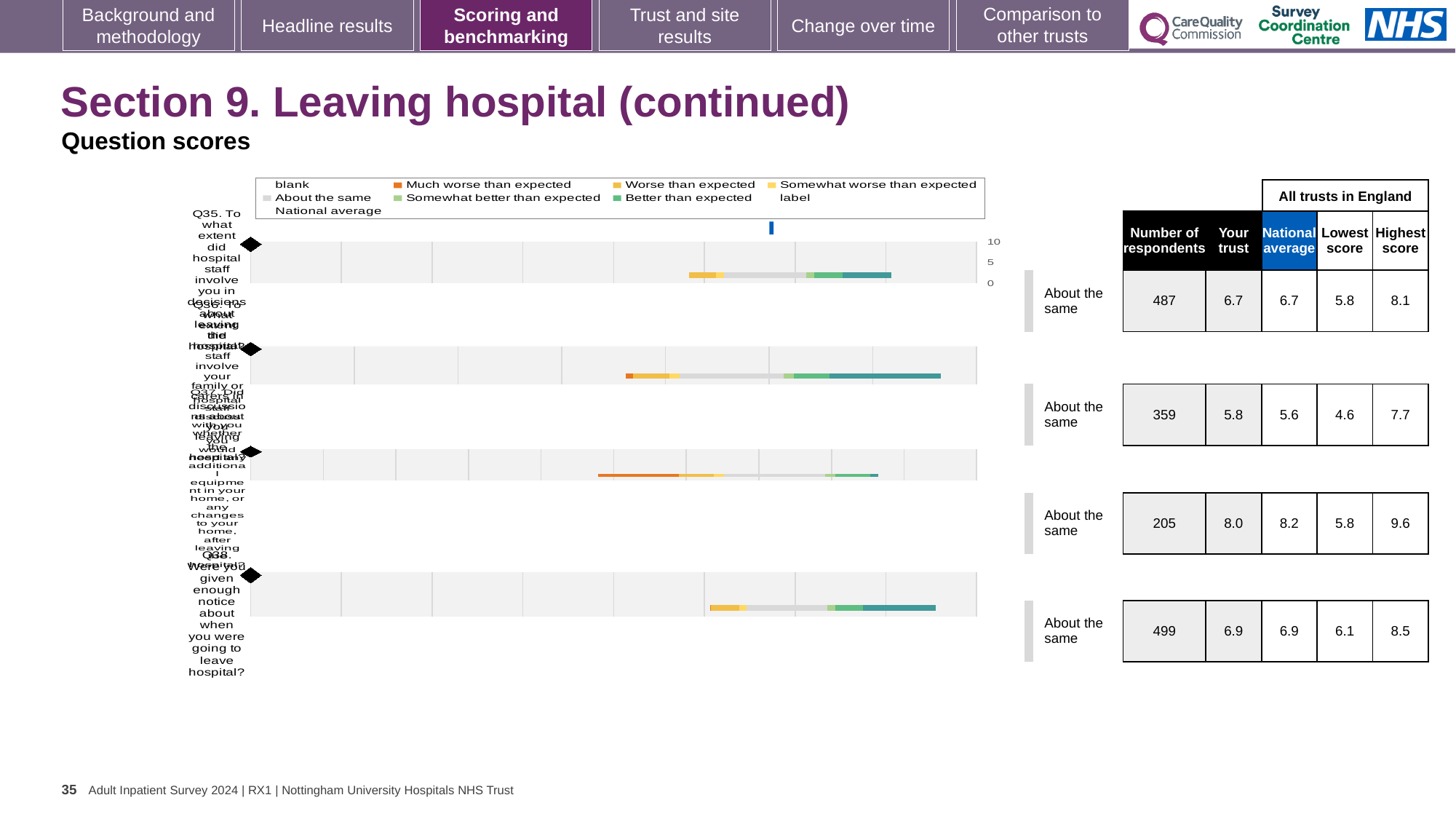
For the third chart from the top, what is the difference between the highest score (9.6) and the lowest score (5.8)? 3.8 For the top chart (Q35, involving you in decisions about leaving hospital), what is the 'Your trust' score shown in the table? 6.7 For the bottom chart (Q38), what is the highest score among all trusts in England? 8.5 How many question-score bar charts are shown on the slide? 4 For the top chart (Q35), how many respondents are listed? 487 Which of the four charts has the highest 'Your trust' score? the third chart from the top (8.0) Which of the four charts has the fewest respondents? the third chart from the top (205) For the bottom chart (Q38, given enough notice about leaving hospital), what is the 'Your trust' score? 6.9 What benchmark category label is shown next to each of the four charts? About the same For the third chart from the top, what is the lowest score among all trusts in England? 5.8 What kind of chart is used for the question scores on this slide? bar chart For the second chart from the top, what is the national average score? 5.6